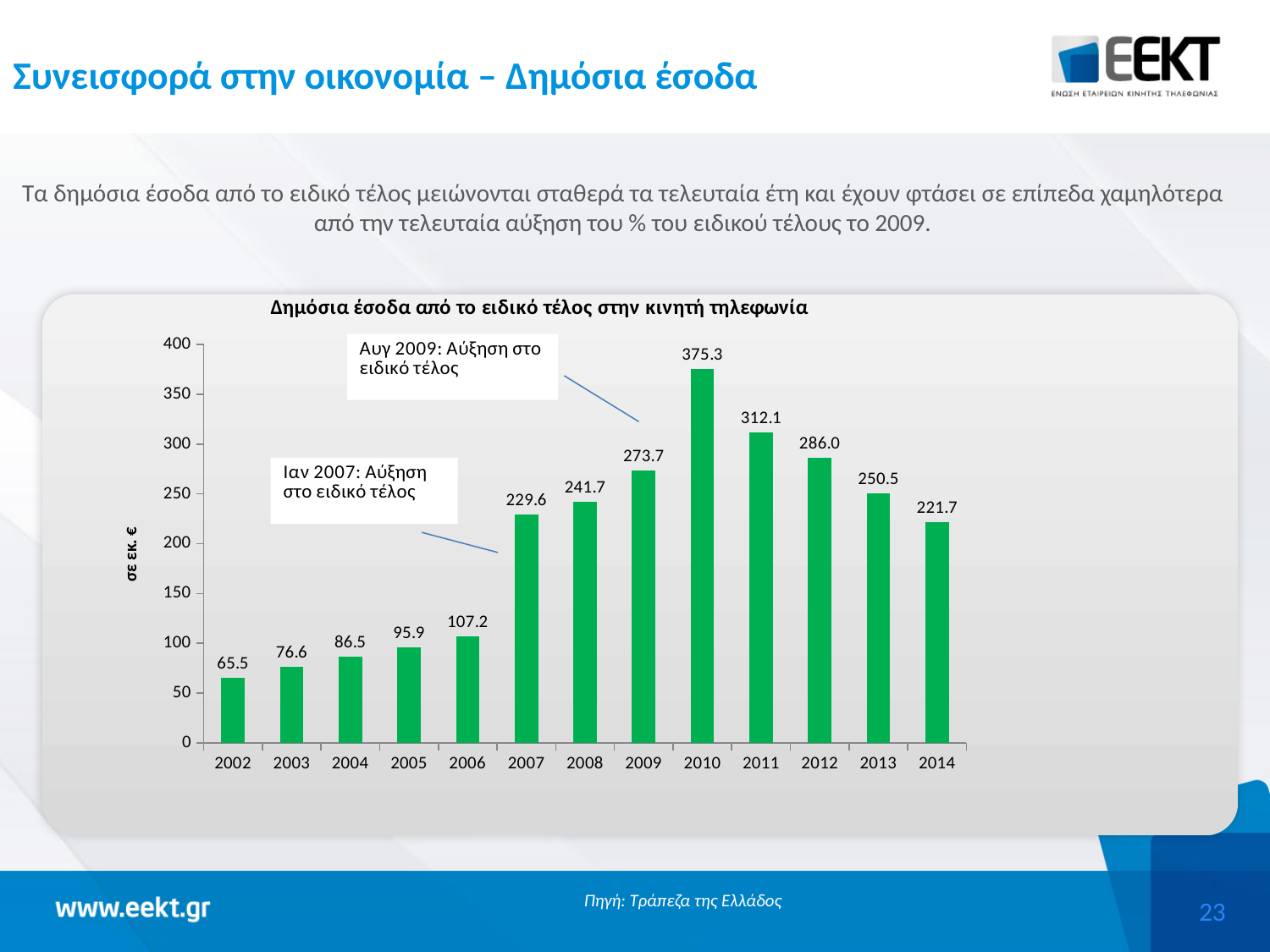
Which year has the lowest value? 2002 Do the values rise or fall from 2010 to 2014? fall Which year has the highest value? 2010 What is the value for 2014? 221.7 What is the value for 2010? 375.3 Is the value for 2011 greater or less than 300? greater What is the difference between the values for 2010 and 2014? 153.6 What kind of chart is shown? bar chart Which is larger, the value for 2007 or the value for 2013? 2013 What is the title of the chart? Δημόσια έσοδα από το ειδικό τέλος στην κινητή τηλεφωνία How many years are shown on the x axis? 13 What is the value for 2002? 65.5